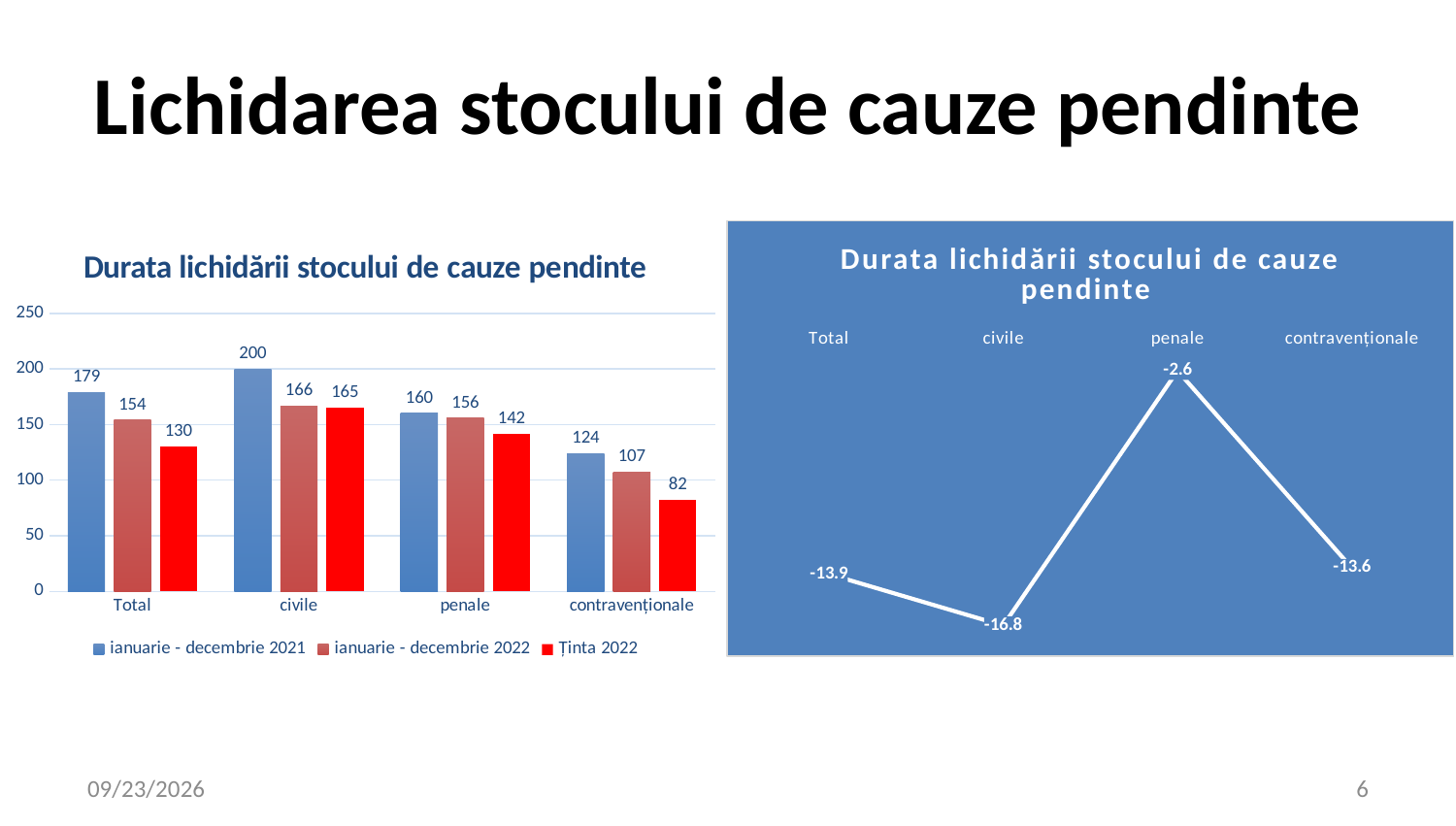
In the left bar chart, which is larger for penale: the ianuarie - decembrie 2022 value or the Ținta 2022 value? ianuarie - decembrie 2022 In the left bar chart, what is the value for penale in the series ianuarie - decembrie 2022? 156 In the left bar chart, which category has the lowest Ținta 2022 value? contravenționale In the left bar chart, what is the value for civile in the series ianuarie - decembrie 2021? 200 In the left bar chart, what is the Ținta 2022 value for contravenționale? 82 In the left bar chart, what is the difference between the ianuarie - decembrie 2021 and ianuarie - decembrie 2022 values for Total? 25 In the left bar chart, which category has the highest value in the series ianuarie - decembrie 2021? civile In the right line chart, which category has the lowest value? civile How many series does the legend of the left bar chart list? 3 How many categories are shown on the x axis of the right line chart? 4 What kind of chart is the chart on the right side of the slide? line chart In the right line chart, what is the value for penale? -2.6